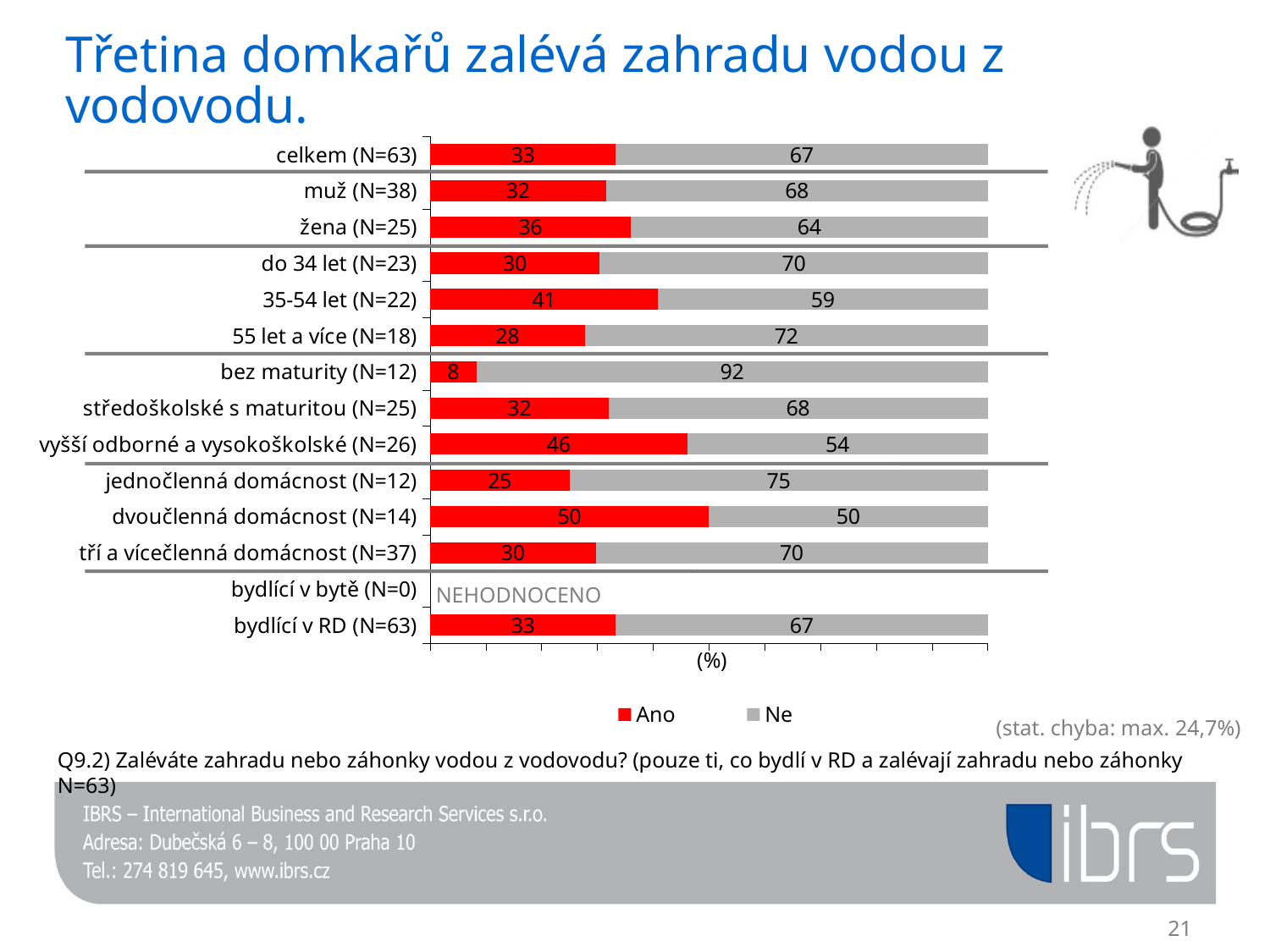
What is the total of the stacked bar for "jednočlenná domácnost (N=12)"? 100 Which has a larger "Ano" value, "muž (N=38)" or "žena (N=25)"? žena (N=25) What is the difference between the "Ano" values for "vyšší odborné a vysokoškolské (N=26)" and "středoškolské s maturitou (N=25)"? 14 How many series does the legend list? 2 What is the "Ano" value for "celkem (N=63)"? 33 Which category has the lowest "Ano" value? bez maturity (N=12) What is the "Ano" value for "35-54 let (N=22)"? 41 Which category has the highest "Ano" value? dvoučlenná domácnost (N=14) What text is shown in place of a bar for "bydlící v bytě (N=0)"? NEHODNOCENO What is the "Ne" value for "bez maturity (N=12)"? 92 What are the two legend entries of the chart? Ano, Ne What kind of chart is shown on the slide? stacked bar chart